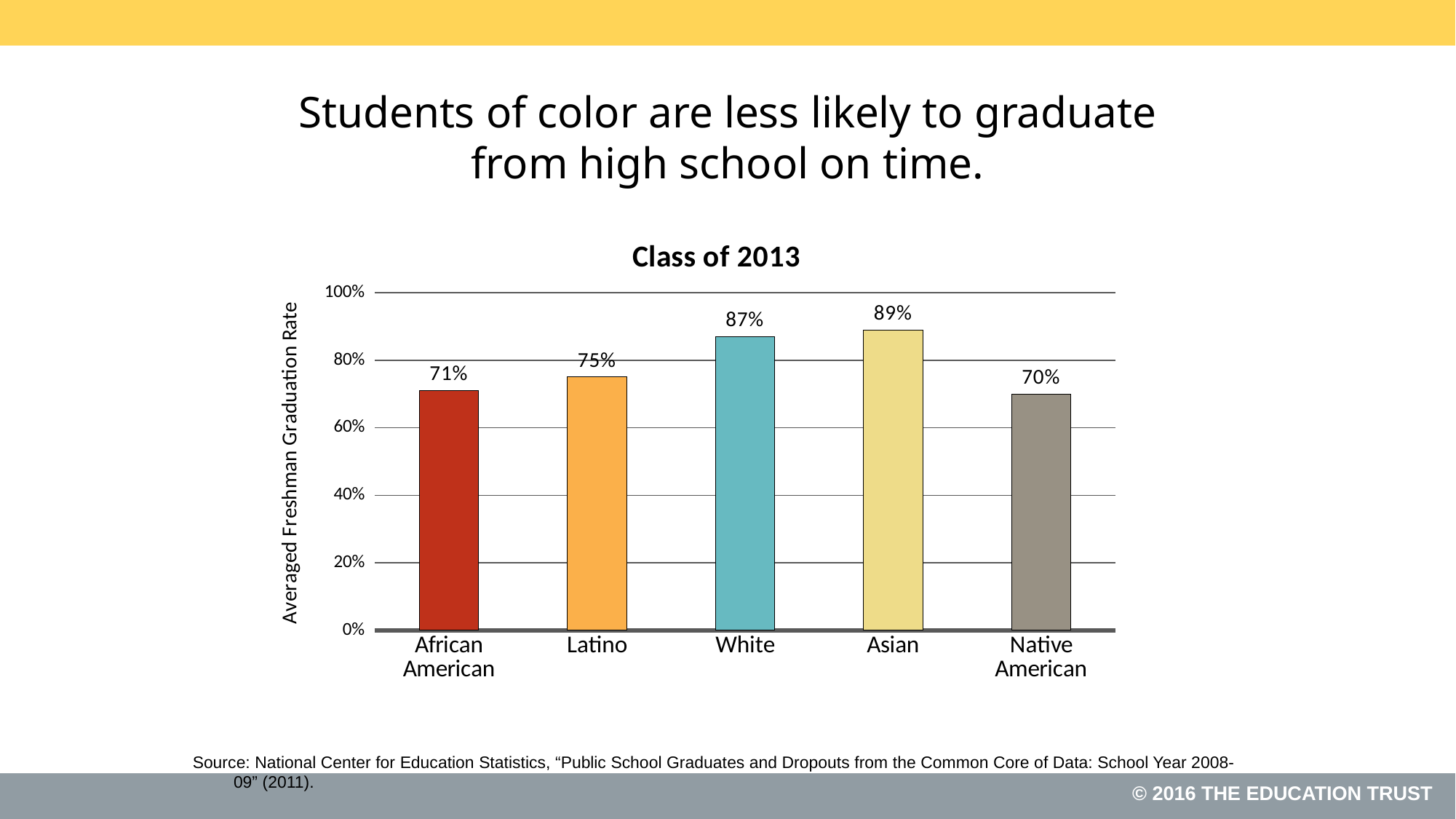
What is the difference between the graduation rates for Asian and African American students? 18% Which group has the lowest graduation rate? Native American Is the value for White students greater or less than 80%? greater Which is larger, the graduation rate for Latino students or for White students? White What is the difference between the graduation rates for White and Latino students? 12% What is the averaged freshman graduation rate for Asian students? 89% What is the title of the chart? Class of 2013 What kind of chart is shown on the slide? bar chart Which group has the highest graduation rate? Asian How many groups are shown on the chart? 5 What is the averaged freshman graduation rate for Native American students? 70% What is the averaged freshman graduation rate for African American students? 71%